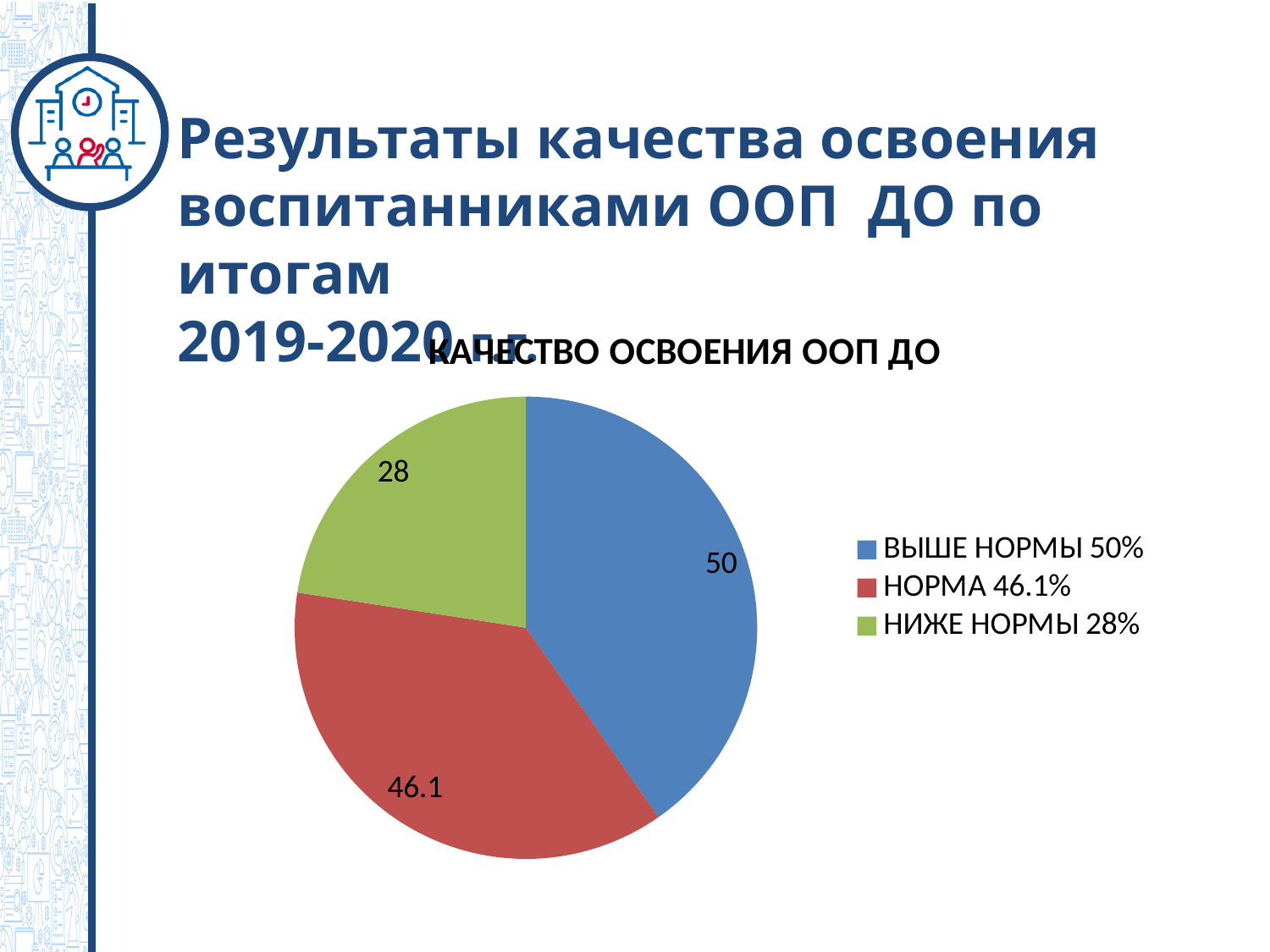
How many slices does the pie chart have? 3 Which category has the smallest slice? НИЖЕ НОРМЫ What colour is the slice for НИЖЕ НОРМЫ? green What is the data label on the slice for НИЖЕ НОРМЫ? 28 What is the title of the chart? КАЧЕСТВО ОСВОЕНИЯ ООП ДО What is the data label on the slice for ВЫШЕ НОРМЫ? 50 What type of chart is shown on the slide? pie chart What is the difference between the values for ВЫШЕ НОРМЫ and НИЖЕ НОРМЫ? 22 What is the difference between the values for НОРМА and НИЖЕ НОРМЫ? 18.1 What is the data label on the slice for НОРМА? 46.1 Which category has the largest slice? ВЫШЕ НОРМЫ Which is larger, the value for НОРМА or the value for НИЖЕ НОРМЫ? НОРМА